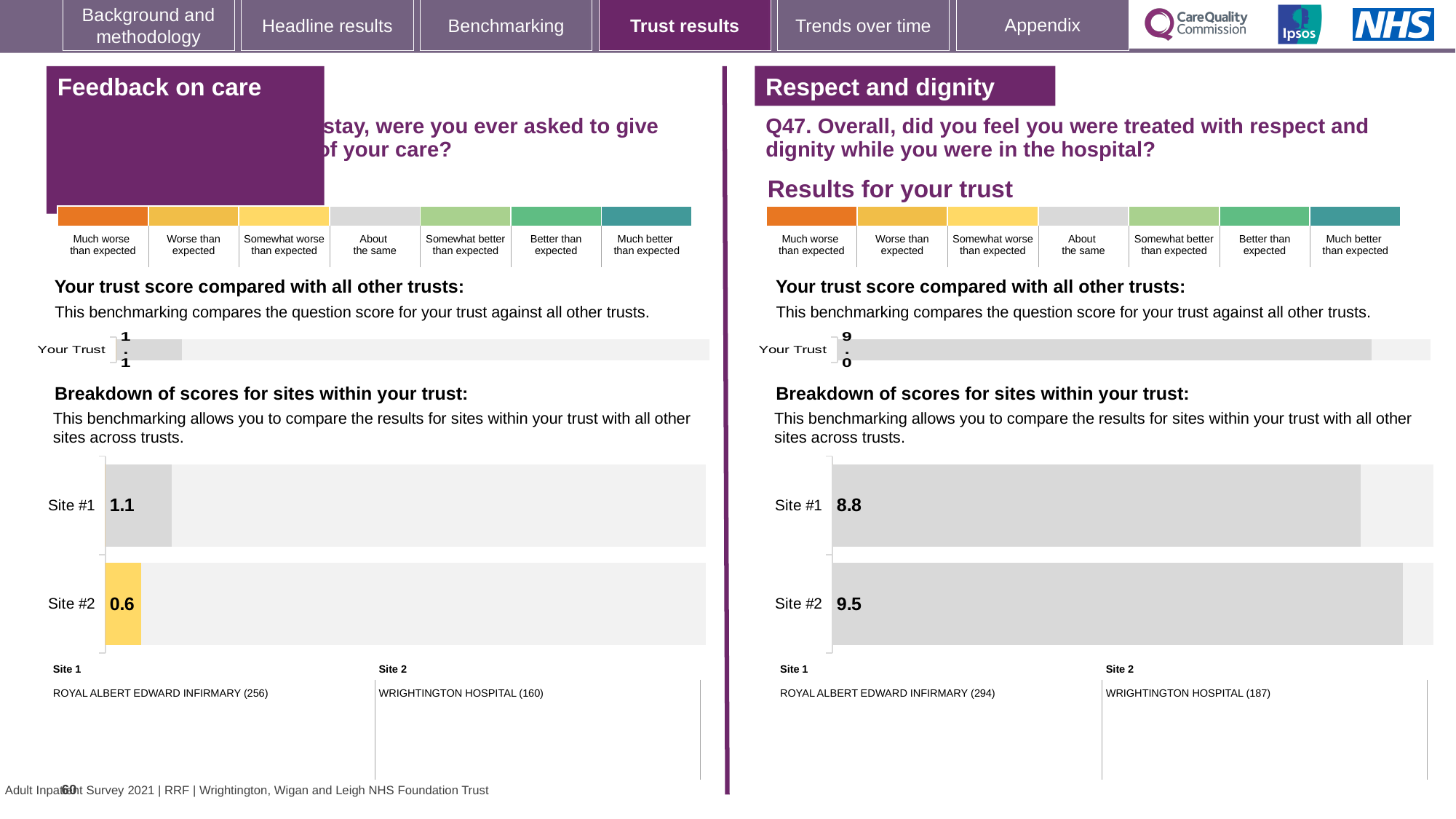
In the 'Feedback on care' trust score chart on the left, what is the value shown for Your Trust? 1.1 In the 'Feedback on care' site breakdown chart on the left, which site has the lower score? Site #2 In the 'Respect and dignity' trust score chart on the right, what is the value shown for Your Trust? 9.0 In the 'Feedback on care' site breakdown chart on the left, what is the score for Site #2? 0.6 What type of chart is used for the site breakdown in the 'Feedback on care' section on the left? Bar chart In the 'Respect and dignity' site breakdown chart on the right, which site has the higher score? Site #2 In the 'Feedback on care' site breakdown chart on the left, what is the difference between the Site #1 and Site #2 scores? 0.5 In the 'Feedback on care' site breakdown chart on the left, what is the score for Site #1? 1.1 How many sites are shown in the 'Respect and dignity' site breakdown chart on the right? 2 In the 'Respect and dignity' site breakdown chart on the right, what is the score for Site #2? 9.5 In the 'Respect and dignity' site breakdown chart on the right, what is the difference between the Site #2 and Site #1 scores? 0.7 In the 'Respect and dignity' site breakdown chart on the right, what is the score for Site #1? 8.8